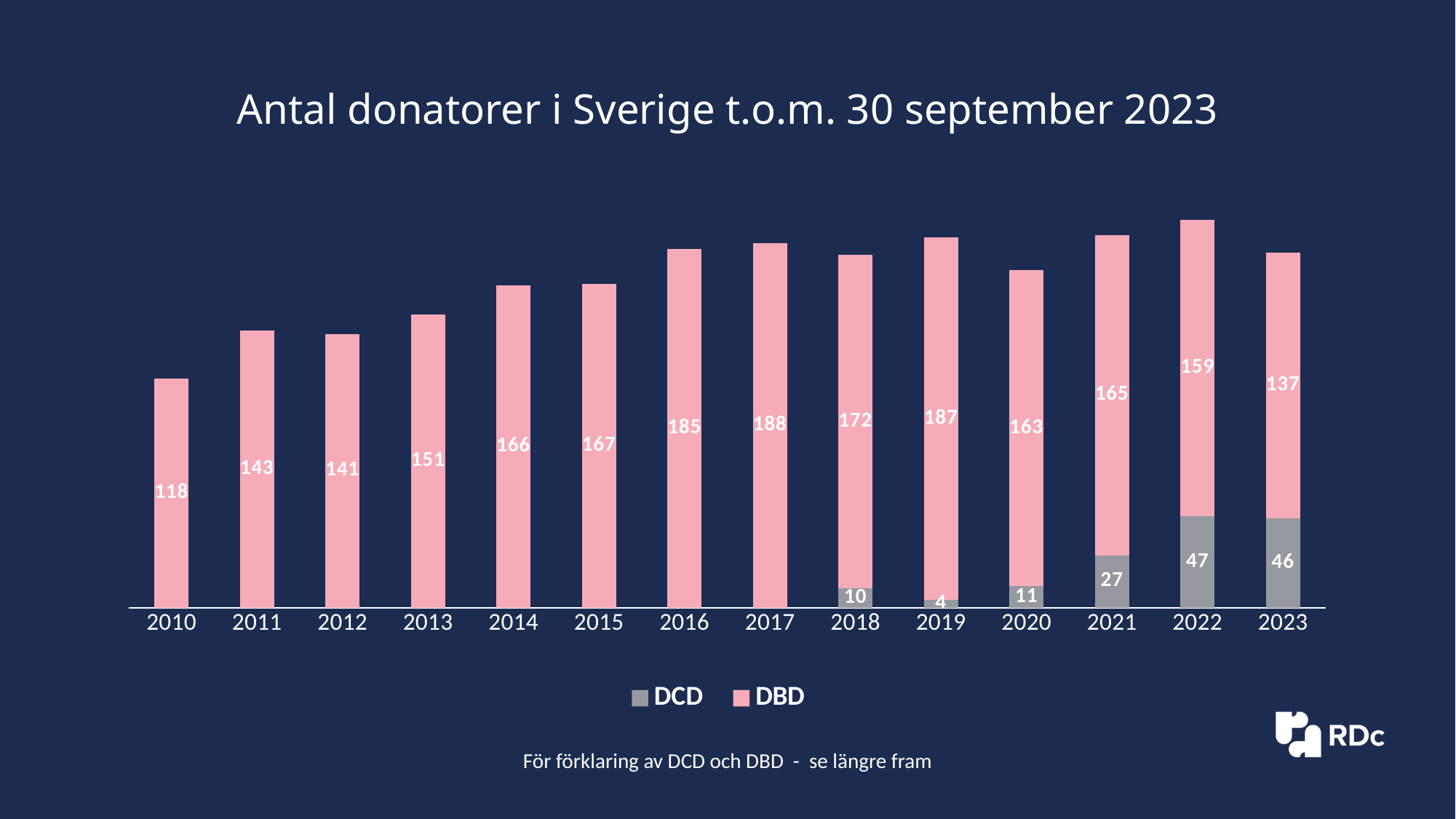
Which is larger, the DBD value for 2014 or the DBD value for 2020? 2014 What type of chart is shown on the slide? Stacked bar chart Which year has the lowest DBD value? 2010 What is the total number of donors (DCD plus DBD) for 2022? 206 How many series does the legend list? 2 What is the difference between the DBD values for 2016 and 2023? 48 How many years are shown on the x axis? 14 What is the DBD value for 2017? 188 Which year has the highest DBD value? 2017 What is the title of the chart? Antal donatorer i Sverige t.o.m. 30 september 2023 What is the DBD value for 2010? 118 What is the DCD value for 2021? 27